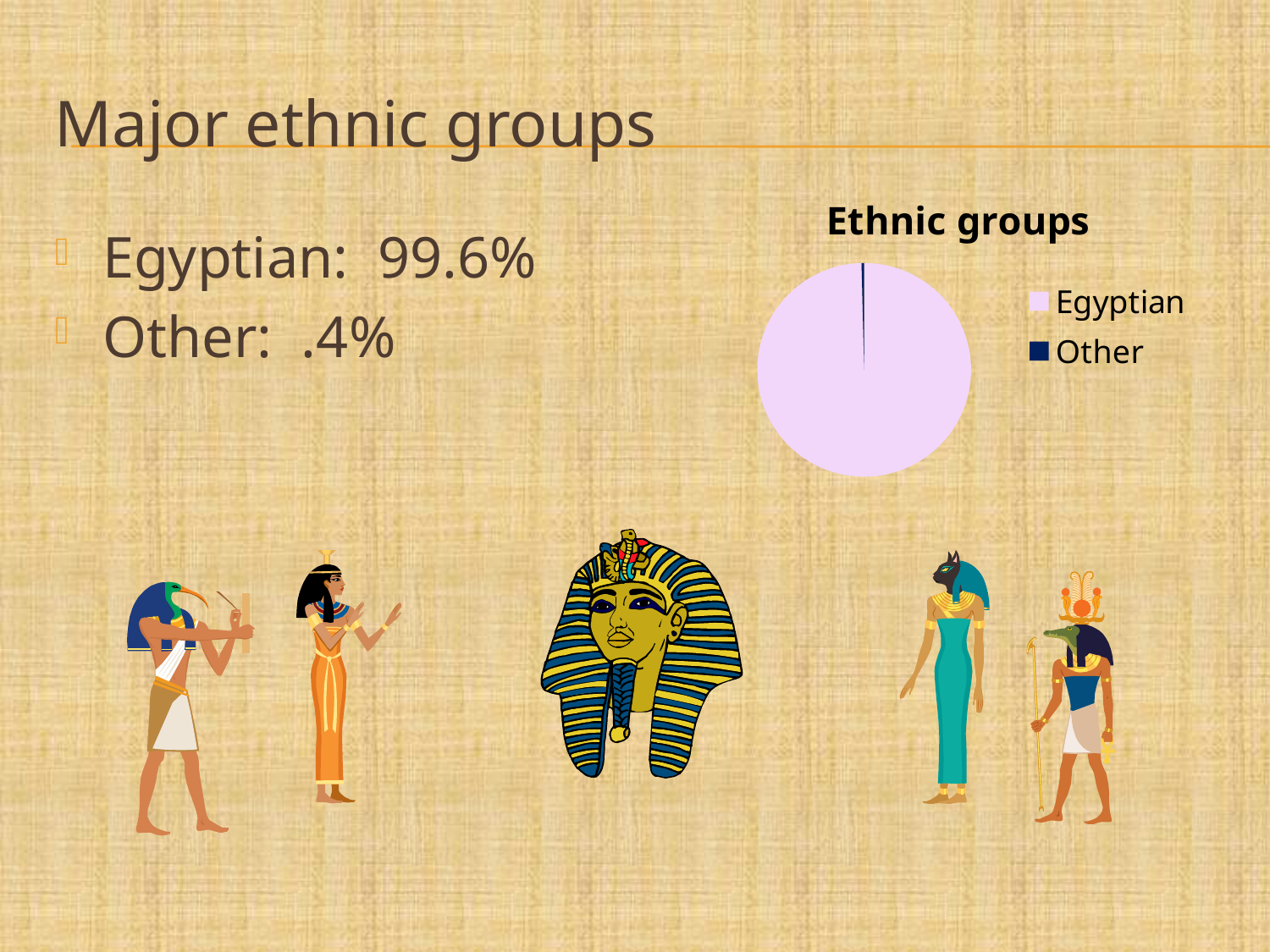
What is the title of the chart on the slide? Ethnic groups How many categories does the "Ethnic groups" pie chart have? 2 According to the slide, what share of the population is Other? .4% How many entries does the legend of the "Ethnic groups" chart list? 2 What value does the slide give for the Egyptian ethnic group? 99.6% What kind of chart is shown under the title "Ethnic groups"? pie chart What value does the slide give for the Other ethnic group? .4% Which category takes up the smallest slice of the "Ethnic groups" pie chart? Other Which category takes up the largest slice of the "Ethnic groups" pie chart? Egyptian Which legend entry of the "Ethnic groups" chart is shown in dark blue? Other According to the slide, what share of the population is Egyptian? 99.6% In the "Ethnic groups" pie chart, which slice is larger, Egyptian or Other? Egyptian